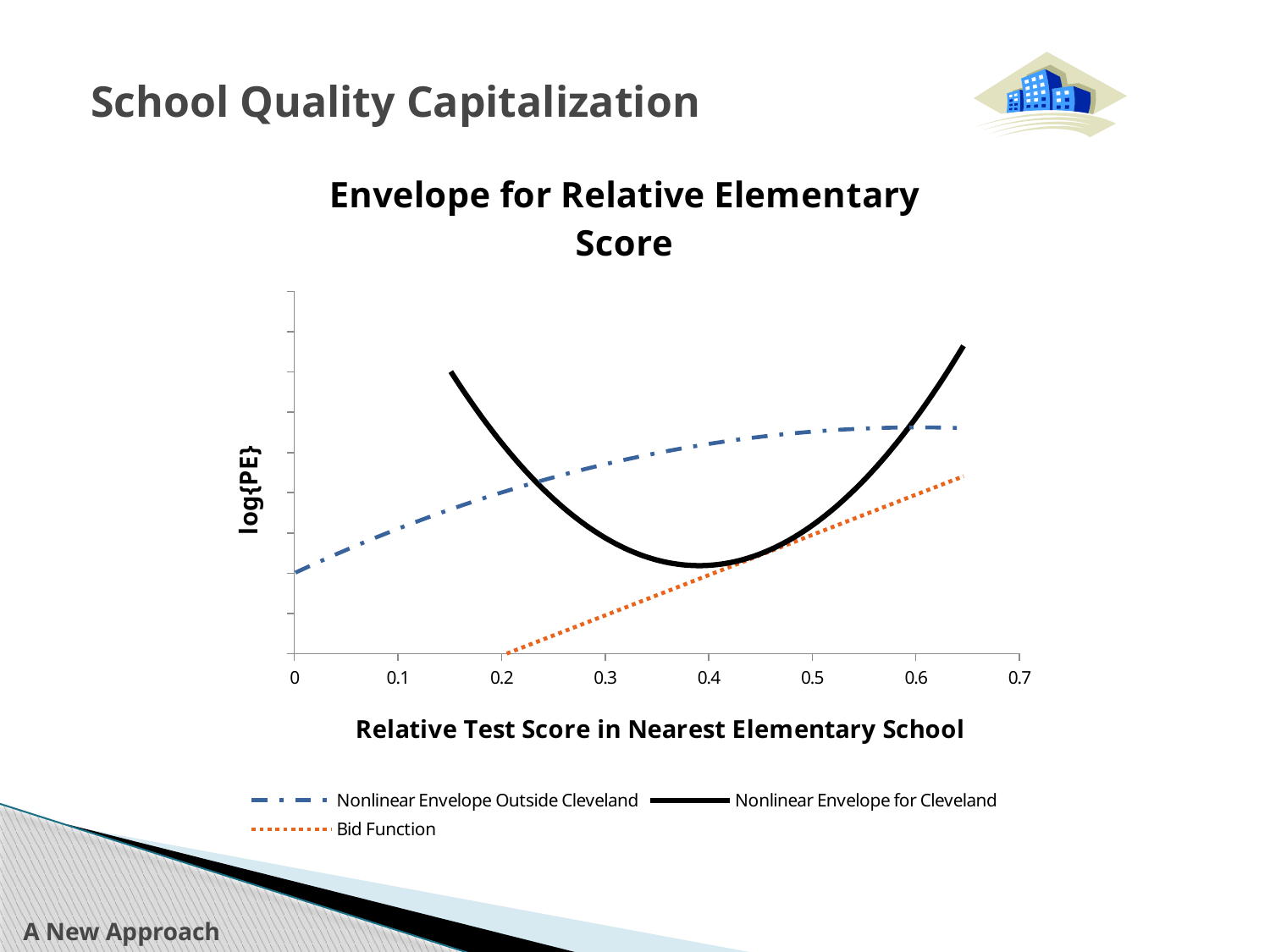
What is the label of the x axis? Relative Test Score in Nearest Elementary School What is the title of the chart? Envelope for Relative Elementary Score Does the Nonlinear Envelope for Cleveland fall and then rise, or rise and then fall, as the relative test score increases? fall and then rise What is the largest value labelled on the x axis? 0.7 Does the Nonlinear Envelope Outside Cleveland rise or fall as the relative test score increases? rise At a relative test score of 0.2, which is higher: the Nonlinear Envelope Outside Cleveland or the Nonlinear Envelope for Cleveland? Nonlinear Envelope for Cleveland At a relative test score of 0.3, which is higher: the Nonlinear Envelope for Cleveland or the Bid Function? Nonlinear Envelope for Cleveland Which series has the lowest value at a relative test score of 0.3? Bid Function Does the Bid Function rise or fall as the relative test score increases? rise Is the relative test score at which the Nonlinear Envelope for Cleveland reaches its minimum greater or less than 0.3? greater How many series does the legend list? 3 What kind of chart is shown on the slide? line chart